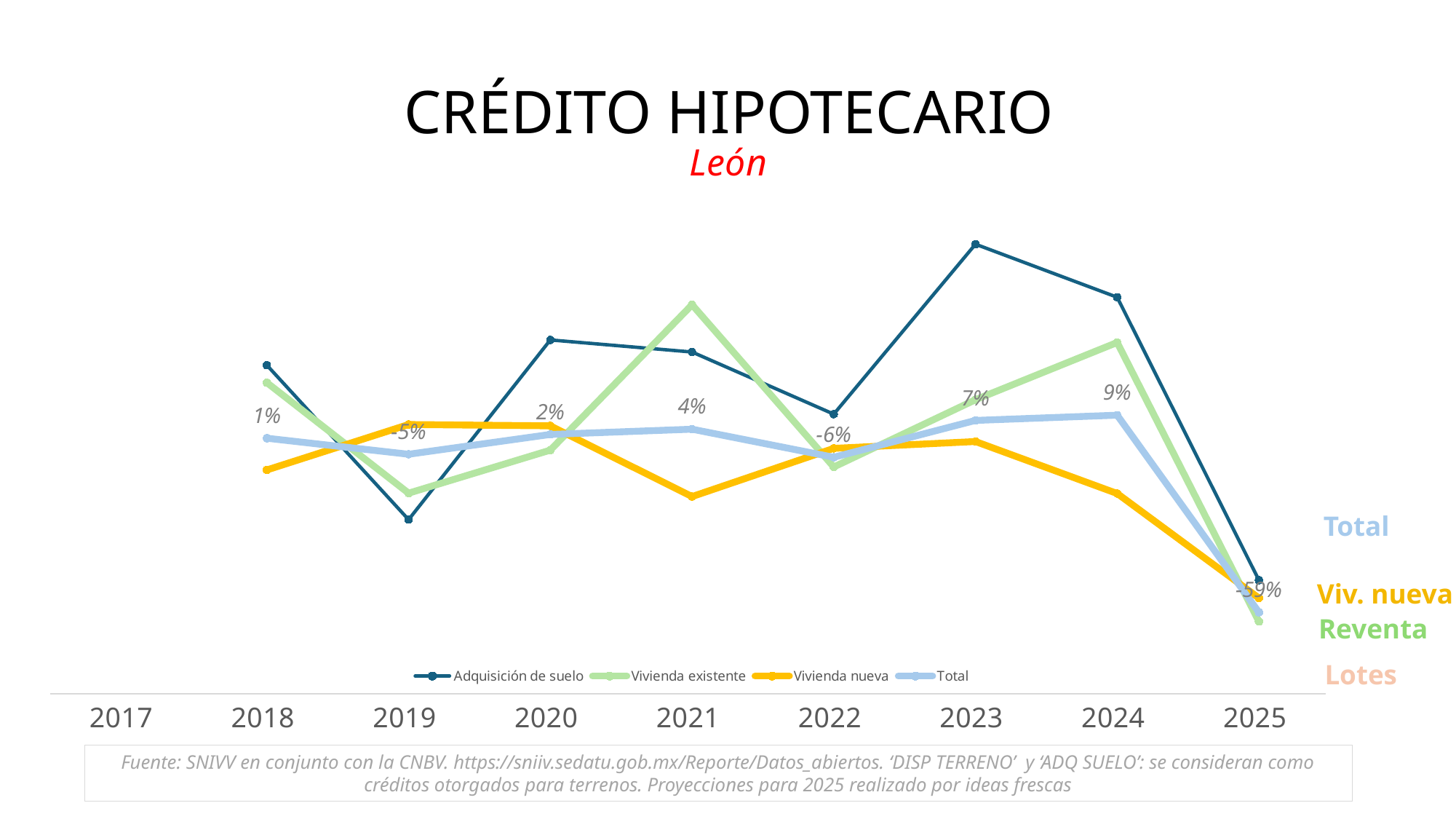
What is the labelled value of the Total series in 2019? -5% How many series does the chart legend list? 4 What is the labelled value of the Total series in 2024? 9% Which city is named in the red subtitle under the chart title? León What is the labelled value of the Total series in 2022? -6% In which year does the Total series have its lowest labelled value? 2025 Which is larger for the Total series: the 2021 label or the 2020 label? 2021 What kind of chart is shown on the slide? line chart Does the Total series rise or fall between 2024 and 2025? fall What is the difference between the Total series labels for 2024 and 2023? 2% What is the labelled value of the Total series in 2025? -59% In which year does the Total series have its highest labelled value? 2024